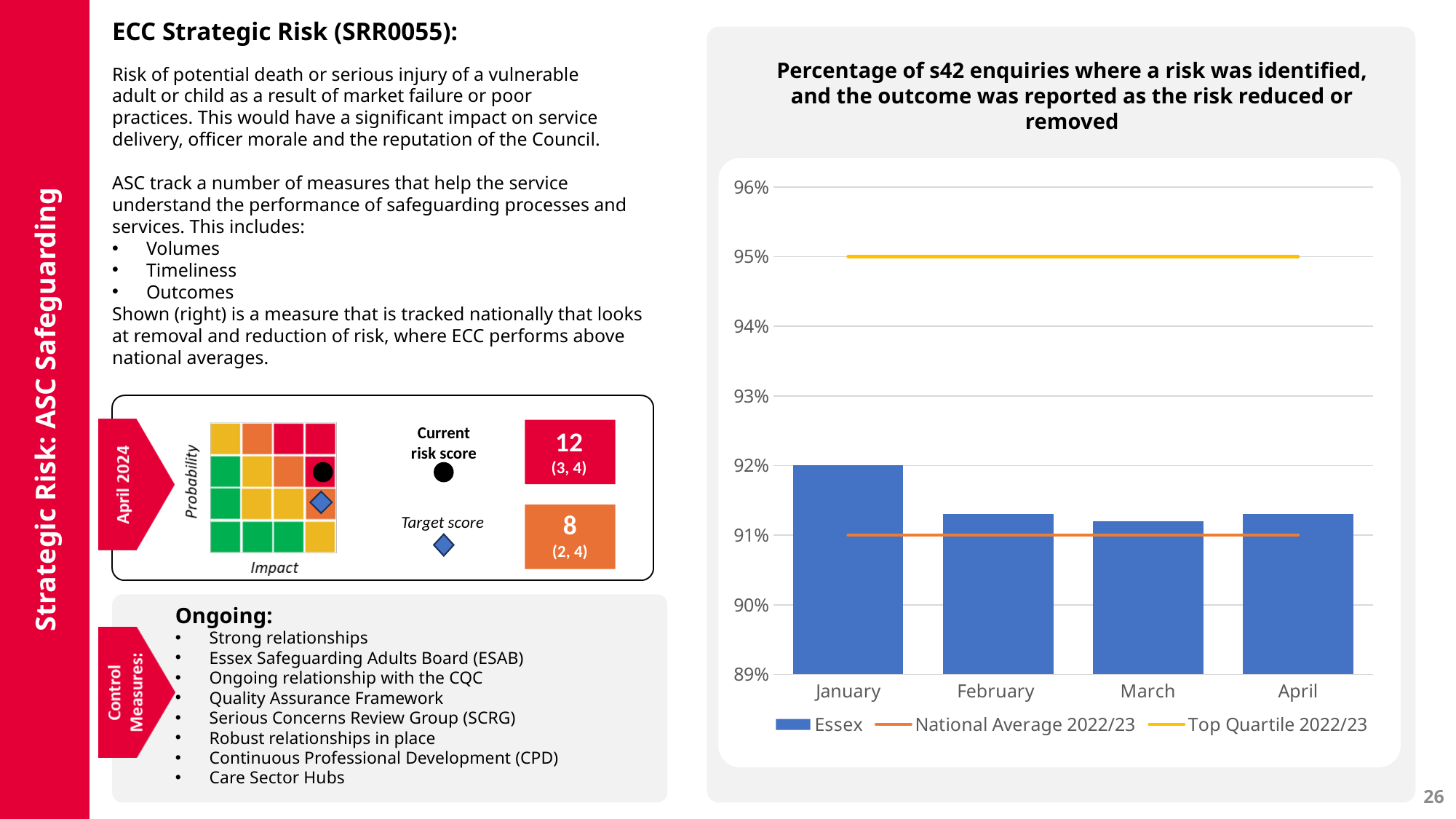
How many series does the chart legend list? 3 Which is larger, the Essex value for January or for March? January What type of chart is shown on the slide? combination bar and line chart What is the difference between the Top Quartile 2022/23 line and the National Average 2022/23 line? 4 percentage points What is the Essex value for January? 92% Is the Essex value for April greater or less than 91%? greater How many months are shown on the x axis of the chart? 4 What value does the National Average 2022/23 line sit at? 91% What value does the Top Quartile 2022/23 line sit at? 95% Does the Essex value rise or fall from January to February? fall Is the Essex value for February greater or less than 92%? less Which month has the highest Essex value? January